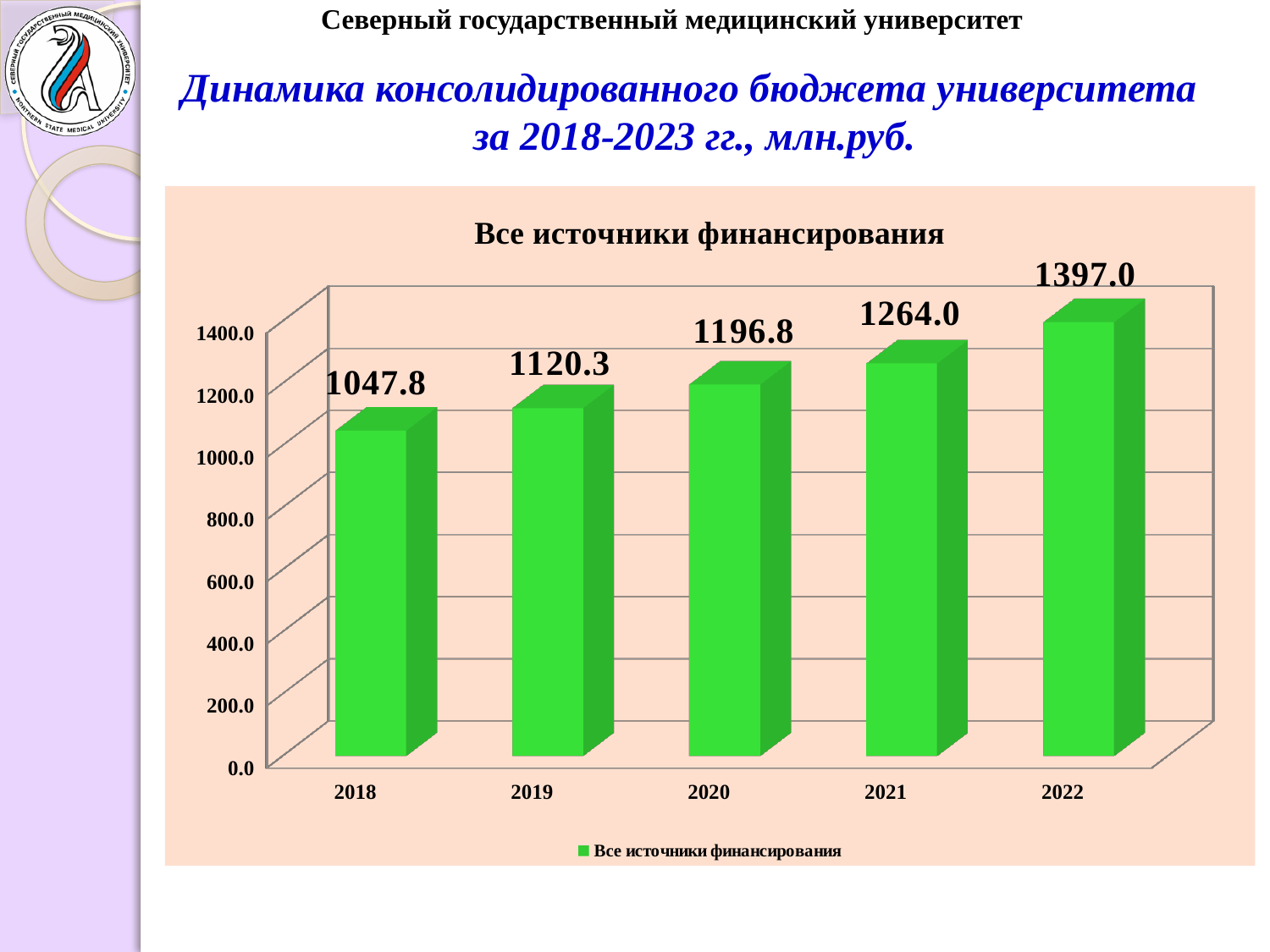
Which year has the highest value? 2022 What is the value for 2020? 1196.8 Is the value for 2019 greater or less than 1000.0? greater Which is larger, the value for 2019 or the value for 2021? 2021 What is the value for 2018? 1047.8 What is the difference between the values for 2022 and 2018? 349.2 What kind of chart is shown? bar chart How many years are shown on the x axis? 5 What is the difference between the values for 2021 and 2020? 67.2 What is the value for 2022? 1397.0 Which year has the lowest value? 2018 Do the values rise or fall from 2018 to 2022? rise